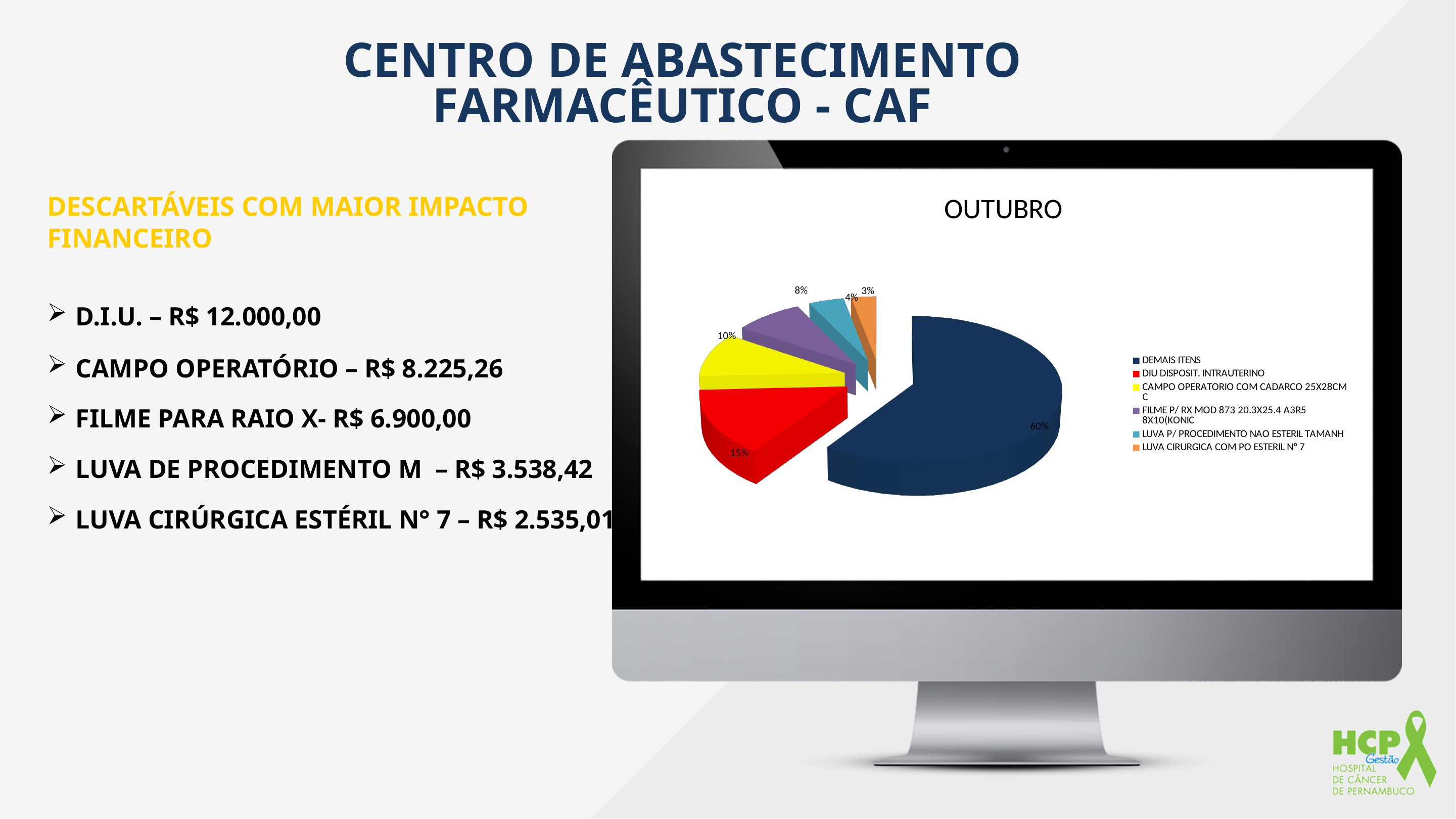
What share of the pie does LUVA CIRURGICA COM PO ESTERIL N° 7 represent? 3% What share of the pie does DIU DISPOSIT. INTRAUTERINO represent? 15% What share of the pie does DEMAIS ITENS represent? 60% What kind of chart is shown on the slide? pie chart How many slices does the pie chart have? 6 Which slice of the pie chart is the largest? DEMAIS ITENS What is the title of the pie chart? OUTUBRO What is the difference in percentage points between DIU DISPOSIT. INTRAUTERINO and LUVA P/ PROCEDIMENTO NAO ESTERIL TAMANH? 11 Which is larger, the share for FILME P/ RX MOD 873 20.3X25.4 A3R5 8X10(KONIC or the share for CAMPO OPERATORIO COM CADARCO 25X28CM C? CAMPO OPERATORIO COM CADARCO 25X28CM C Which slice of the pie chart is the smallest? LUVA CIRURGICA COM PO ESTERIL N° 7 What colour is the DEMAIS ITENS slice in the pie chart? dark blue